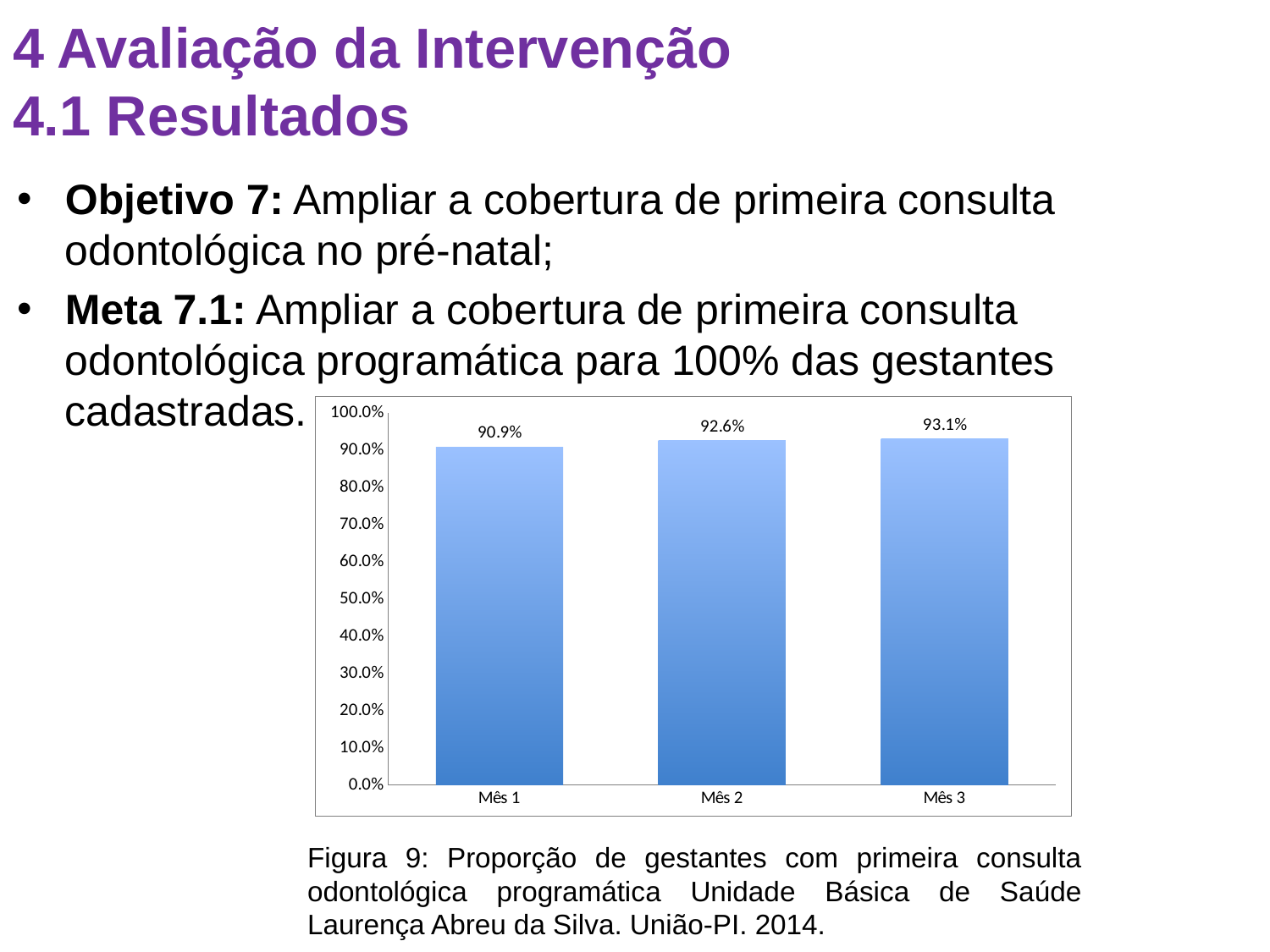
How many months are shown on the x axis? 3 What is the value for Mês 2? 92.6% What is the difference between the values for Mês 2 and Mês 1? 1.7% What is the value for Mês 3? 93.1% What kind of chart is shown on the slide? bar chart Do the values rise or fall from Mês 1 to Mês 3? rise Which month has the highest value? Mês 3 Is the value for Mês 3 greater or less than 100.0%? less What is the value for Mês 1? 90.9% Which month has the lowest value? Mês 1 Which is larger, the value for Mês 2 or the value for Mês 1? Mês 2 What is the difference between the values for Mês 3 and Mês 1? 2.2%